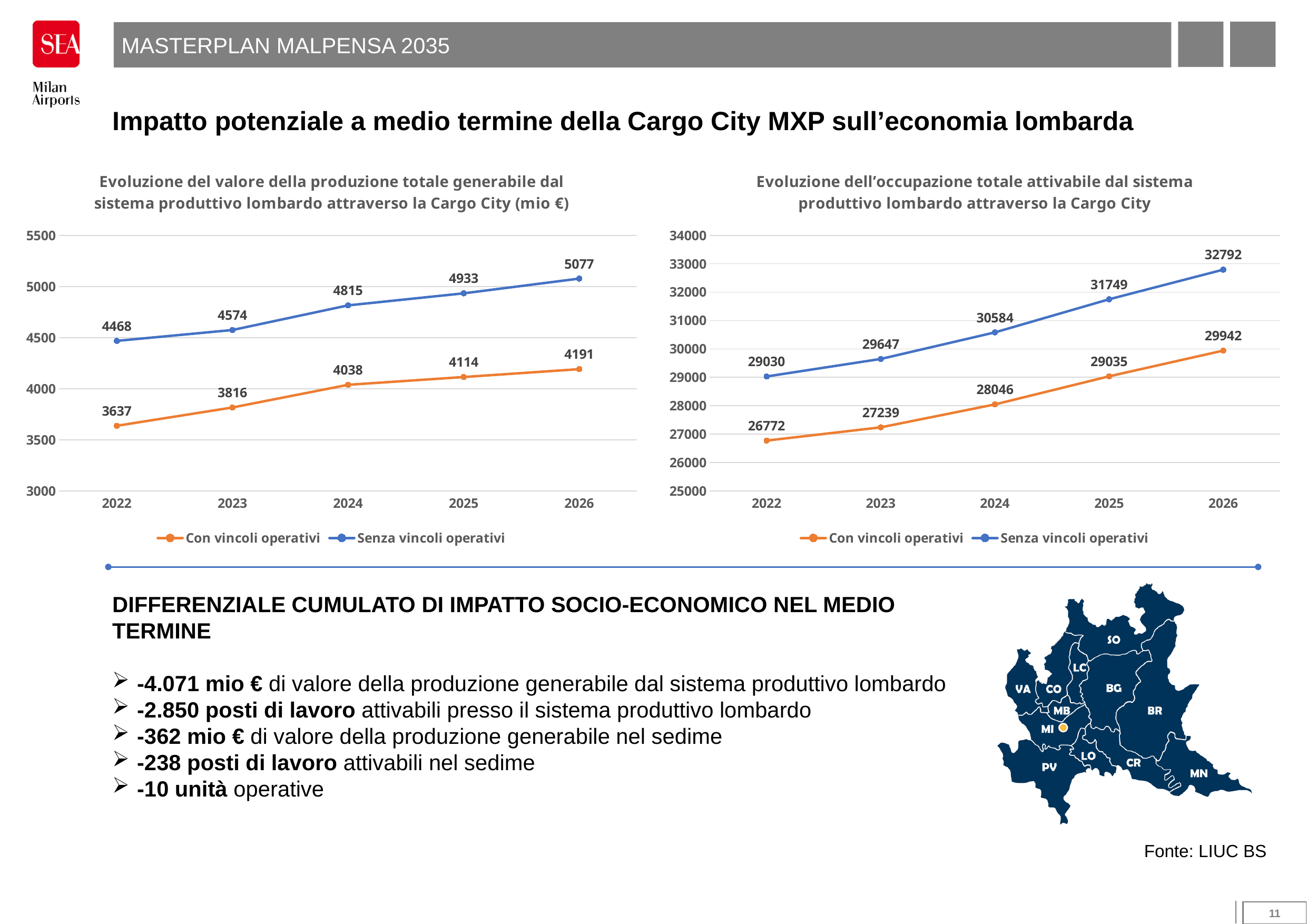
In the right chart (Evoluzione dell'occupazione totale), what is the value for Con vincoli operativi in 2025? 29035 In the right chart (Evoluzione dell'occupazione totale), what is the value for Senza vincoli operativi in 2024? 30584 How many series does the legend of the left chart (Evoluzione del valore della produzione totale) list? 2 In the left chart (Evoluzione del valore della produzione totale), what is the value for Senza vincoli operativi in 2026? 5077 In the left chart (Evoluzione del valore della produzione totale), which is larger in 2023: Con vincoli operativi or Senza vincoli operativi? Senza vincoli operativi In the left chart (Evoluzione del valore della produzione totale), what is the difference between Senza vincoli operativi and Con vincoli operativi in 2024? 777 In the left chart (Evoluzione del valore della produzione totale), in which year is the Senza vincoli operativi value highest? 2026 In the right chart (Evoluzione dell'occupazione totale), what is the difference between Senza vincoli operativi and Con vincoli operativi in 2026? 2850 In the left chart (Evoluzione del valore della produzione totale), what is the value for Con vincoli operativi in 2022? 3637 In the right chart (Evoluzione dell'occupazione totale), in which year is the Con vincoli operativi value lowest? 2022 What kind of chart is the right chart (Evoluzione dell'occupazione totale)? line chart In the right chart (Evoluzione dell'occupazione totale), does the Senza vincoli operativi series rise or fall from 2022 to 2026? rise